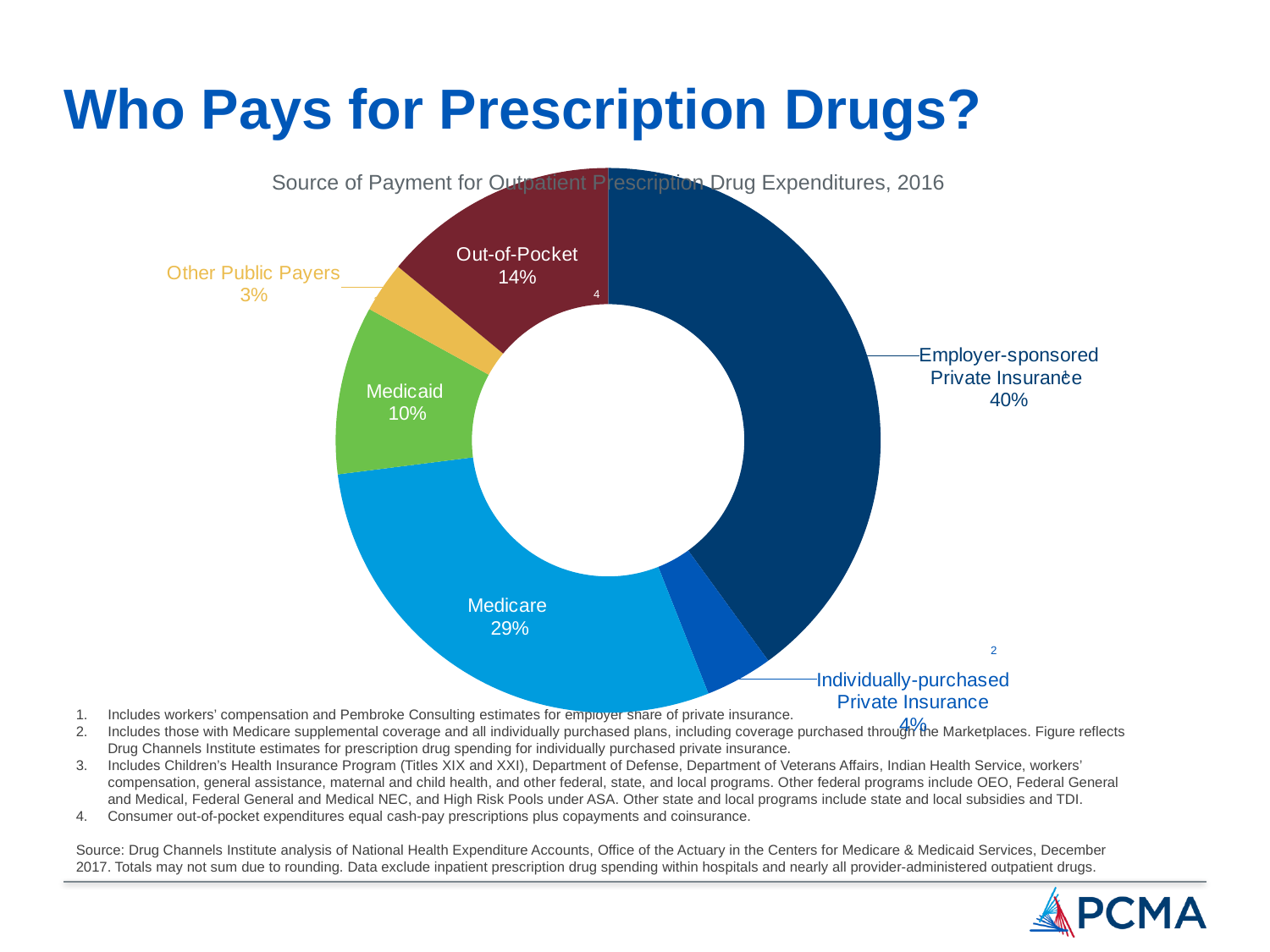
Which is larger: the Out-of-Pocket share or the Medicaid share? Out-of-Pocket Which source of payment has the largest share of the pie? Employer-sponsored Private Insurance What type of chart is shown on the slide? Pie chart (donut) What percentage of the pie is attributed to Medicare? 29% What is the Out-of-Pocket share shown on the chart? 14% How many payment sources (slices) are shown in the chart? 6 Which source of payment has the smallest share of the pie? Other Public Payers What is the title of the chart? Source of Payment for Outpatient Prescription Drug Expenditures, 2016 What share of outpatient prescription drug expenditures is paid by Employer-sponsored Private Insurance? 40% What share is shown for Medicaid? 10% How many percentage points larger is the Medicare share than the Medicaid share? 19 What percentage is shown for Individually-purchased Private Insurance? 4%